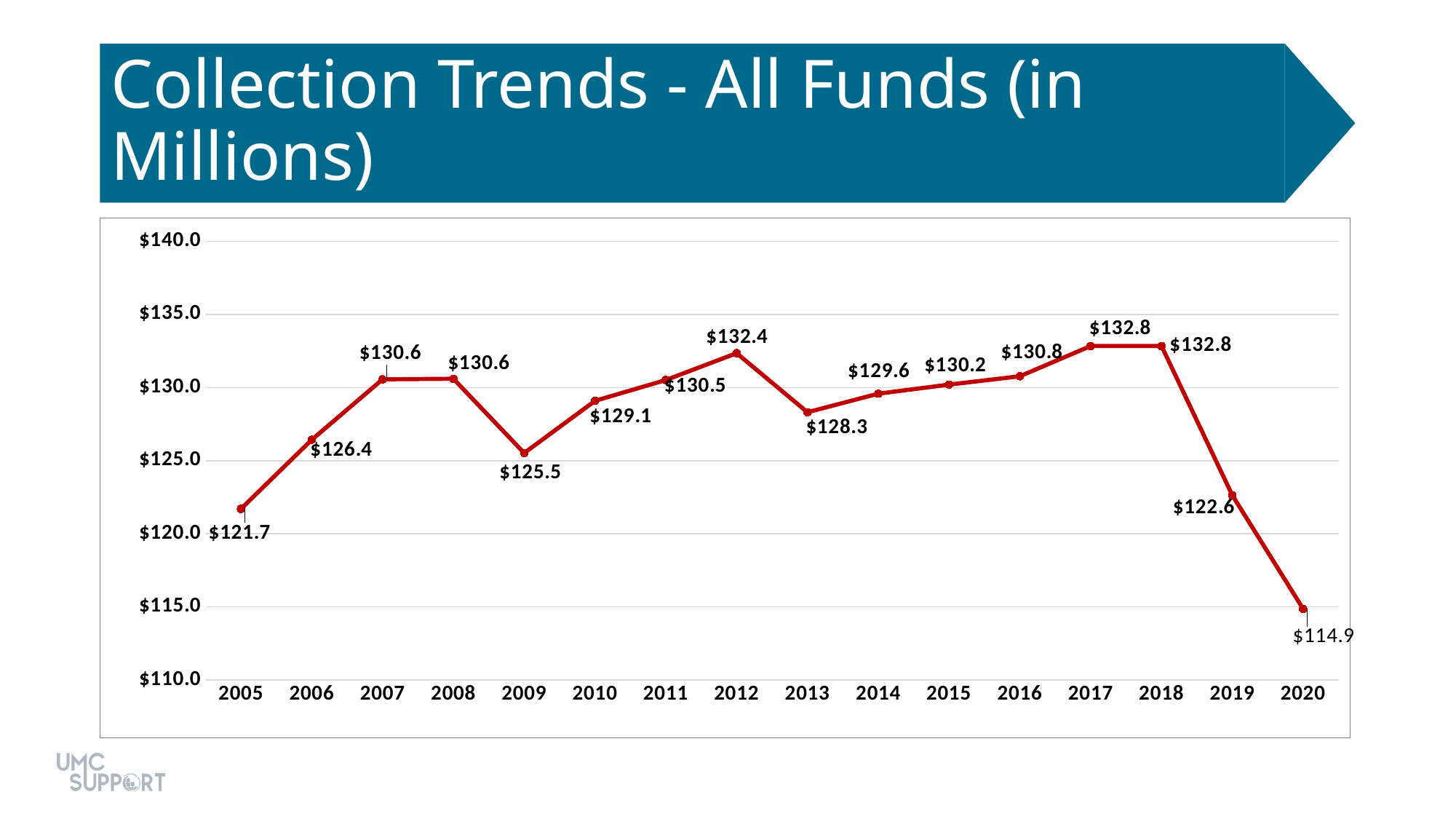
Do the values rise or fall from 2018 to 2020? Fall Which is larger, the value for 2012 or the value for 2016? 2012 What is the value for 2012? $132.4 What type of chart is shown on the slide? Line chart What is the value for 2005? $121.7 What is the highest value plotted on the chart? $132.8 What is the value for 2009? $125.5 What is the difference between the values for 2019 and 2020? $7.7 How many years are plotted on the chart? 16 Which year has the lowest value? 2020 What is the difference between the values for 2012 and 2013? $4.1 What is the value for 2020? $114.9